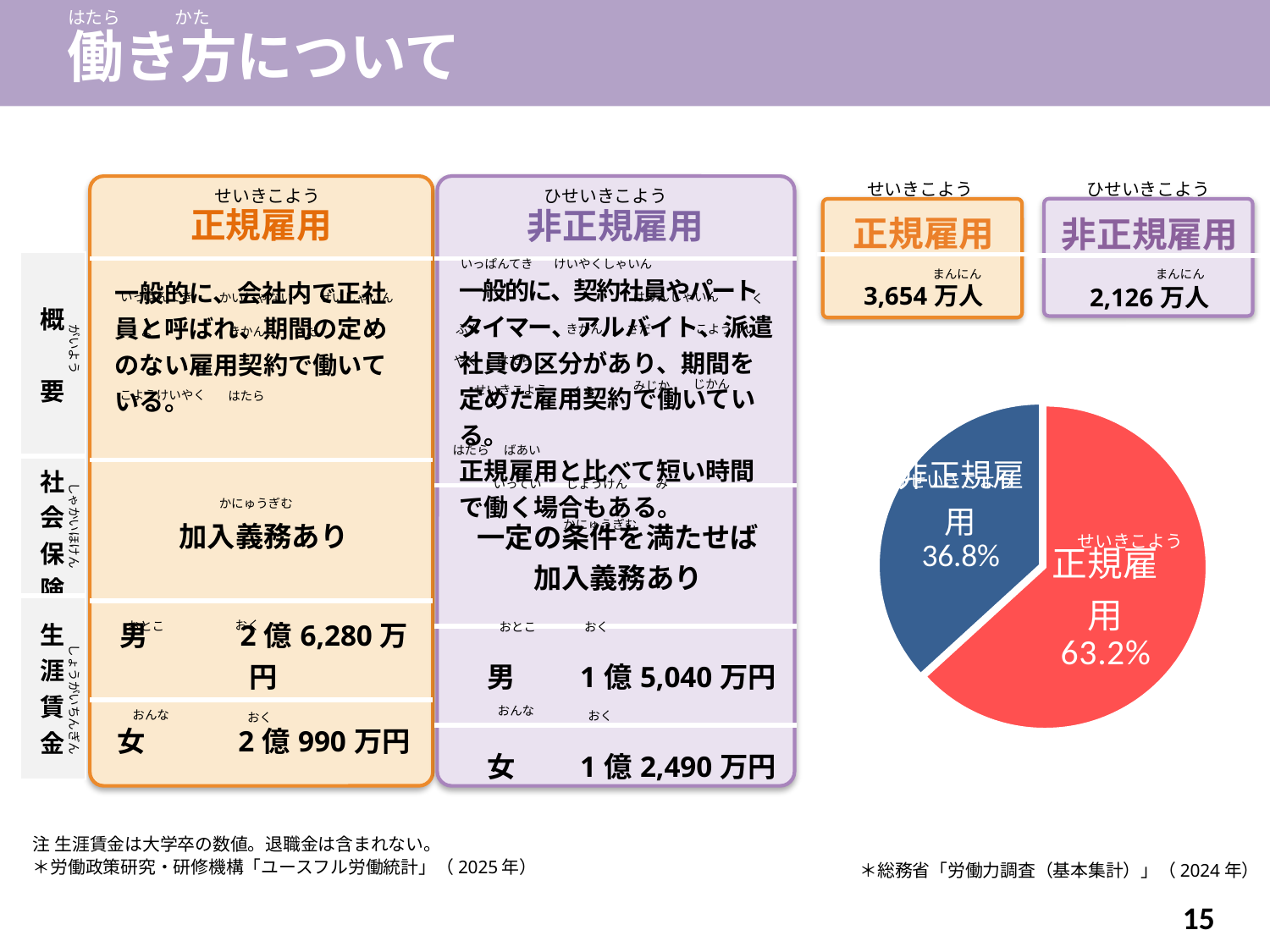
Which slice of the pie chart is the smallest? 非正規雇用 Is the share for 非正規雇用 in the pie chart greater or less than 50%? less How many slices does the pie chart have? 2 In the pie chart, what share is shown for 正規雇用? 63.2% In the pie chart, what share is shown for 非正規雇用? 36.8% Which is larger in the pie chart, 正規雇用 or 非正規雇用? 正規雇用 What kind of chart is shown on the slide? pie chart By how many percentage points does the 正規雇用 share exceed the 非正規雇用 share in the pie chart? 26.4 percentage points What colour is the 非正規雇用 slice in the pie chart? blue What colour is the 正規雇用 slice in the pie chart? red Which slice of the pie chart is the largest? 正規雇用